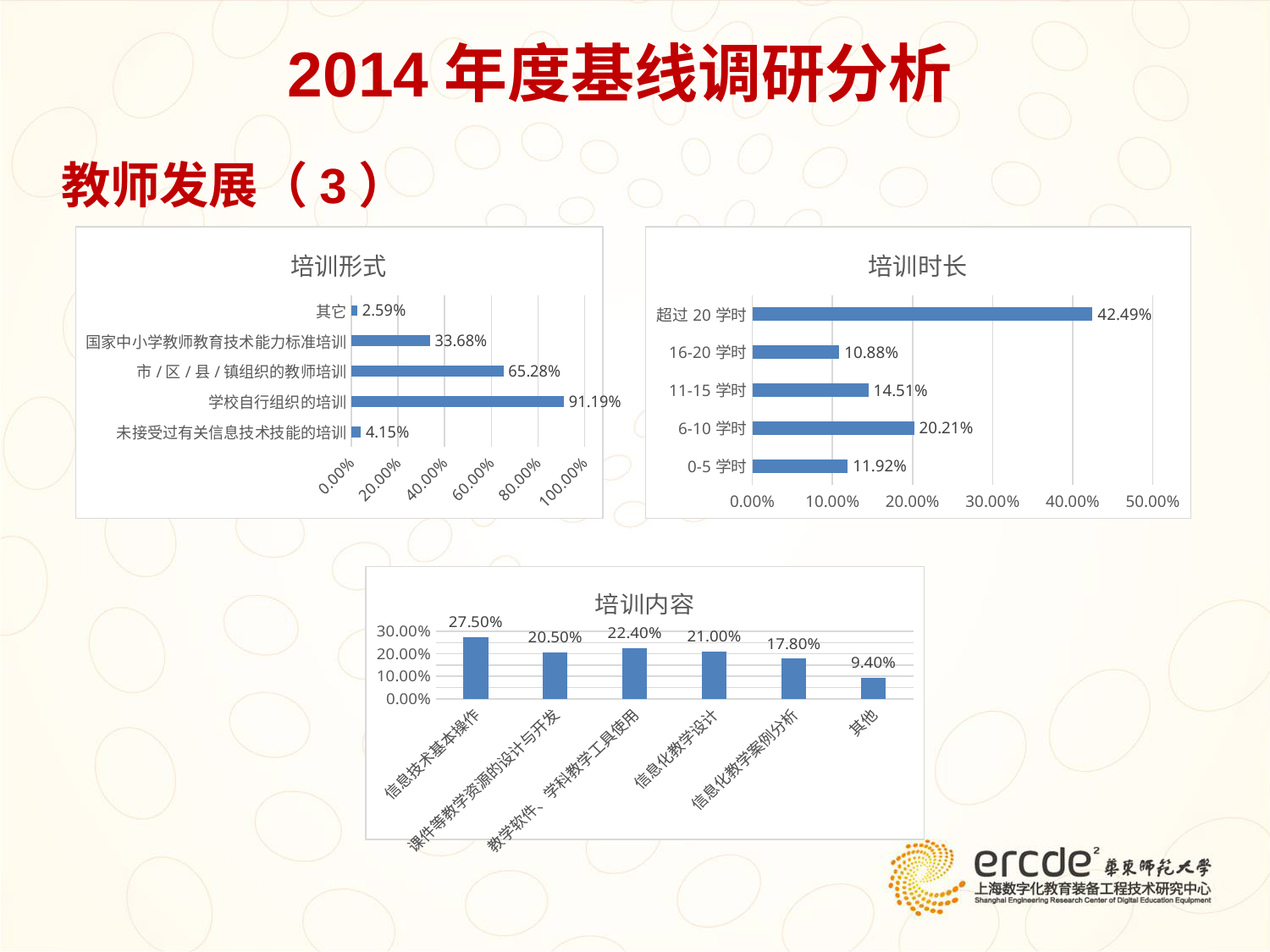
In the 培训形式 chart, what is the difference between 市／区／县／镇组织的教师培训 and 国家中小学教师教育技术能力标准培训? 31.60% In the 培训形式 chart, what is the value for 学校自行组织的培训? 91.19% In the 培训形式 chart, which category has the lowest value? 其它 In the 培训内容 chart, which category has the highest value? 信息技术基本操作 In the 培训形式 chart, how many categories are shown? 5 In the 培训时长 chart, what is the difference between 超过 20 学时 and 11-15 学时? 27.98% In the 培训内容 chart, how many categories are shown? 6 In the 培训内容 chart, what is the value for 信息化教学案例分析? 17.80% In the 培训时长 chart, which category has the highest value? 超过 20 学时 In the 培训时长 chart, what is the value for 6-10 学时? 20.21% In the 培训时长 chart, which is larger, 0-5 学时 or 16-20 学时? 0-5 学时 What type of chart is the 培训内容 chart? Bar chart